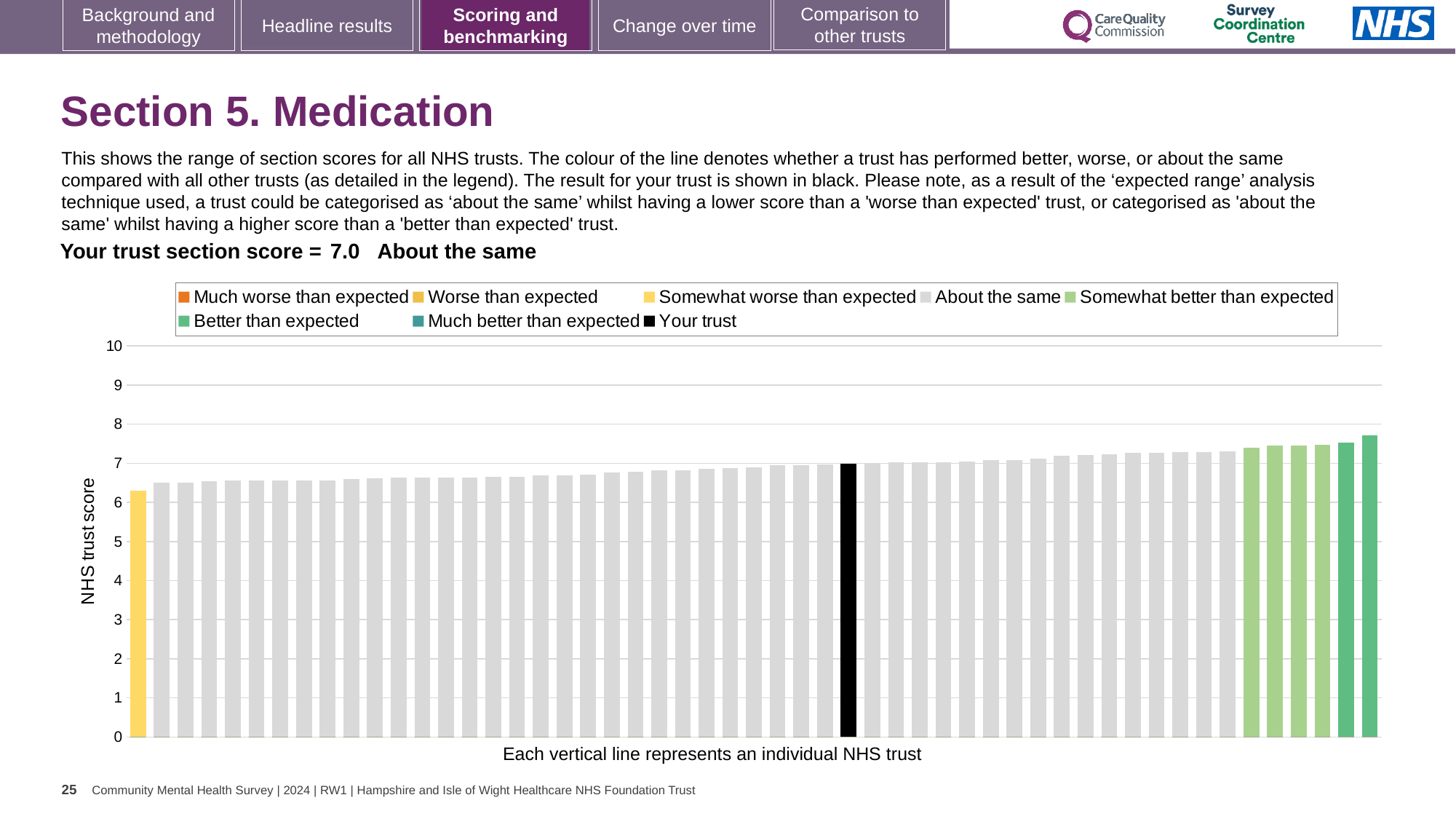
What is the label on the vertical axis of the chart? NHS trust score How many entries does the chart legend list? 8 Is the value of the leftmost (lowest) bar greater or less than 7? less Is the value of the rightmost (highest) bar greater or less than 7? greater Is the value of the leftmost (lowest) bar greater or less than 6? greater What kind of chart is shown on the slide? Bar chart Is the rightmost bar higher or lower than the black bar for your trust? Higher How is your trust's section score categorised compared with other trusts? About the same Do the bar values rise or fall from left to right along the x axis? Rise What is the section score for your trust shown on the slide? 7.0 What colour is the bar representing your trust? Black